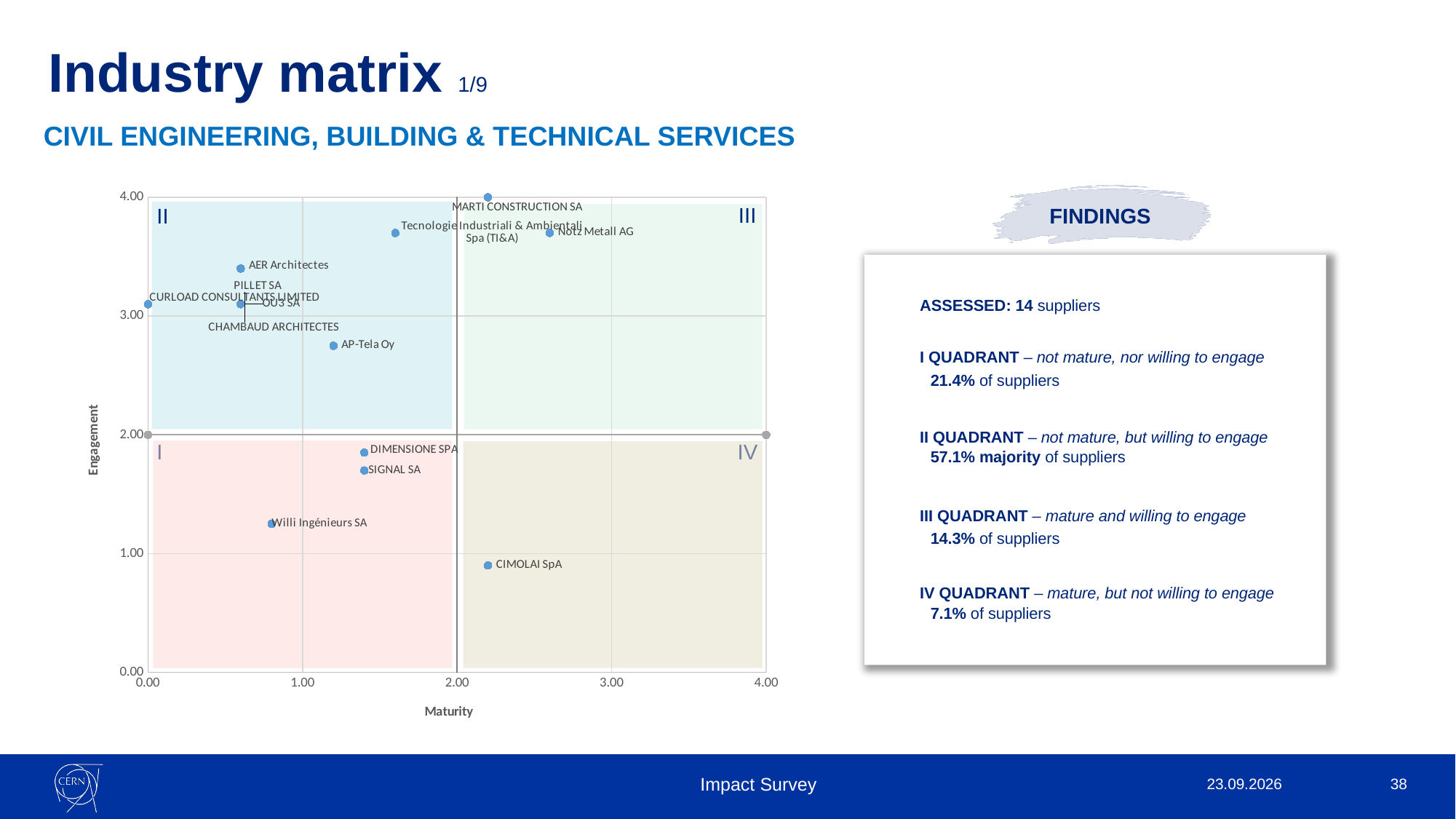
What is the label of the vertical axis of the chart? Engagement Which supplier has a higher engagement value, AER Architectes or AP-Tela Oy? AER Architectes Is the maturity value for AP-Tela Oy greater or less than 1.00? greater What kind of chart is shown on the slide? scatter chart In which quadrant of the chart is Willi Ingénieurs SA plotted? I What is the engagement value for MARTI CONSTRUCTION SA? 4.00 Which supplier has the lowest engagement value in the chart? CIMOLAI SpA Which supplier has the highest engagement value in the chart? MARTI CONSTRUCTION SA What is the label of the horizontal axis of the chart? Maturity Is the maturity value for Notz Metall AG greater or less than 2.00? greater Which supplier has the highest maturity value in the chart? Notz Metall AG Is the engagement value for CIMOLAI SpA greater or less than 1.00? less